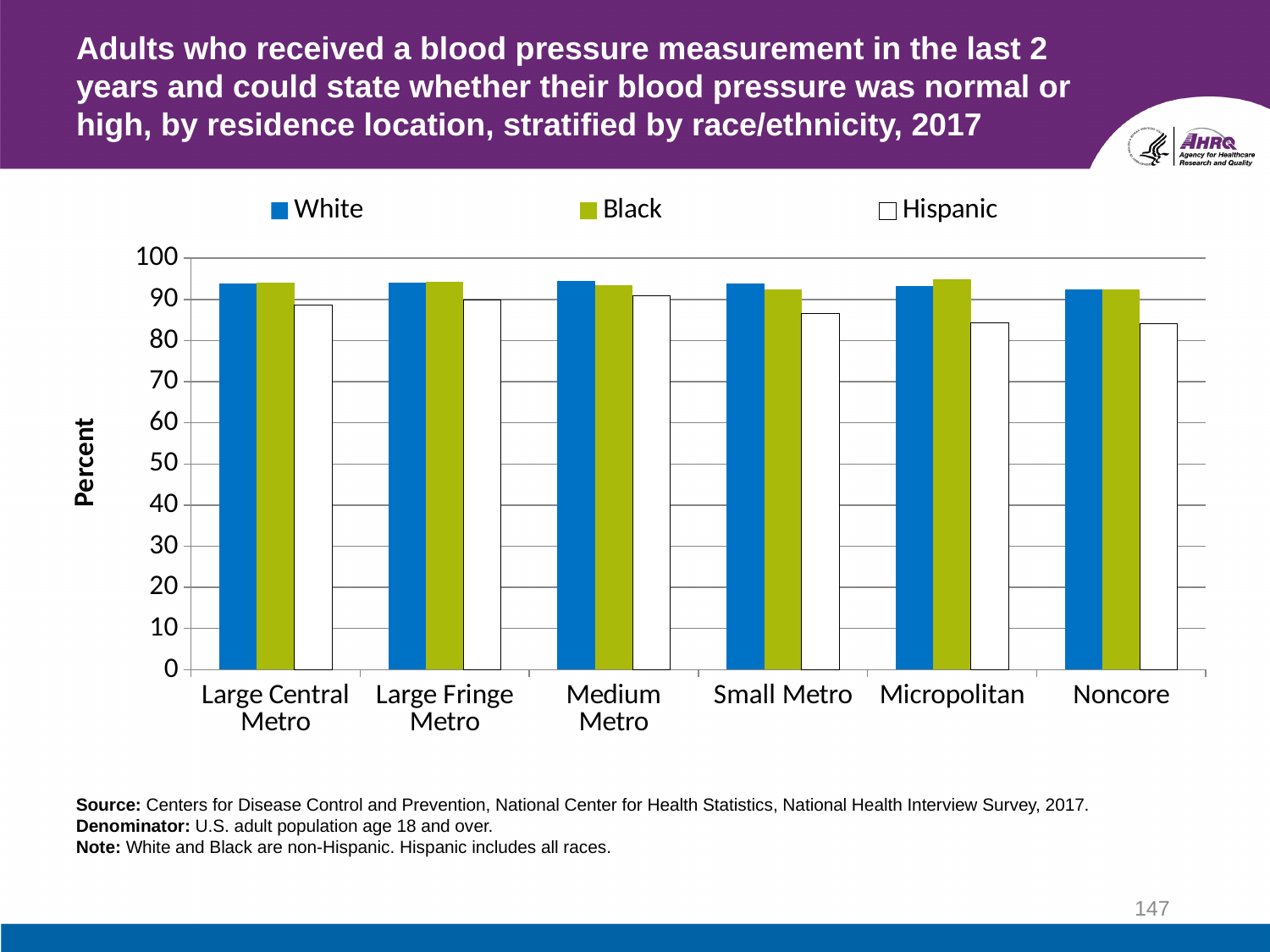
How many residence location categories are shown on the x axis? 6 How many series does the legend list? 3 Is the value for Black in Micropolitan greater or less than 90? greater Is the value for White in Large Central Metro greater or less than 90? greater Which race/ethnicity group has the lowest value in Micropolitan? Hispanic What kind of chart is shown on the slide? Bar chart In Micropolitan, which is larger, the value for White or the value for Hispanic? White In Small Metro, which is larger, the value for Black or the value for Hispanic? Black Is the value for Hispanic in Noncore greater or less than 90? less What is the label on the y axis? Percent